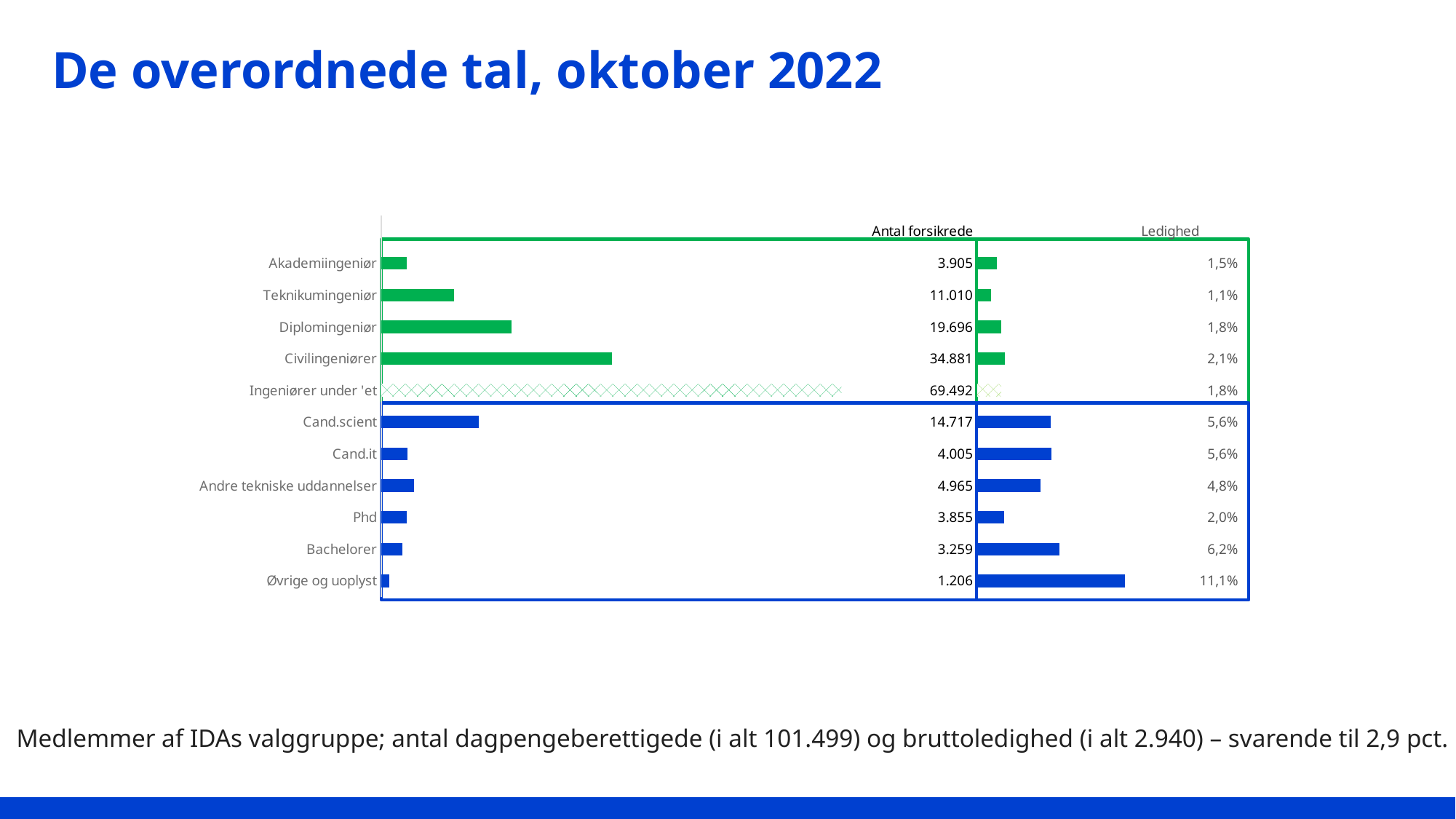
What is the Antal forsikrede value for Civilingeniører? 34.881 What is the Ledighed value for Øvrige og uoplyst? 11,1% What kind of chart is shown on the slide? Bar chart What is the difference in Ledighed between Bachelorer and Phd? 4,2% How many categories are shown on the chart? 11 Which has a larger Antal forsikrede value, Diplomingeniør or Cand.scient? Diplomingeniør Which category has the lowest Ledighed value? Teknikumingeniør How many series does the chart show? 2 Which category has the highest Ledighed value? Øvrige og uoplyst What is the Antal forsikrede value for Cand.scient? 14.717 What is the Ledighed value for Teknikumingeniør? 1,1% Which category has the lowest Antal forsikrede value? Øvrige og uoplyst